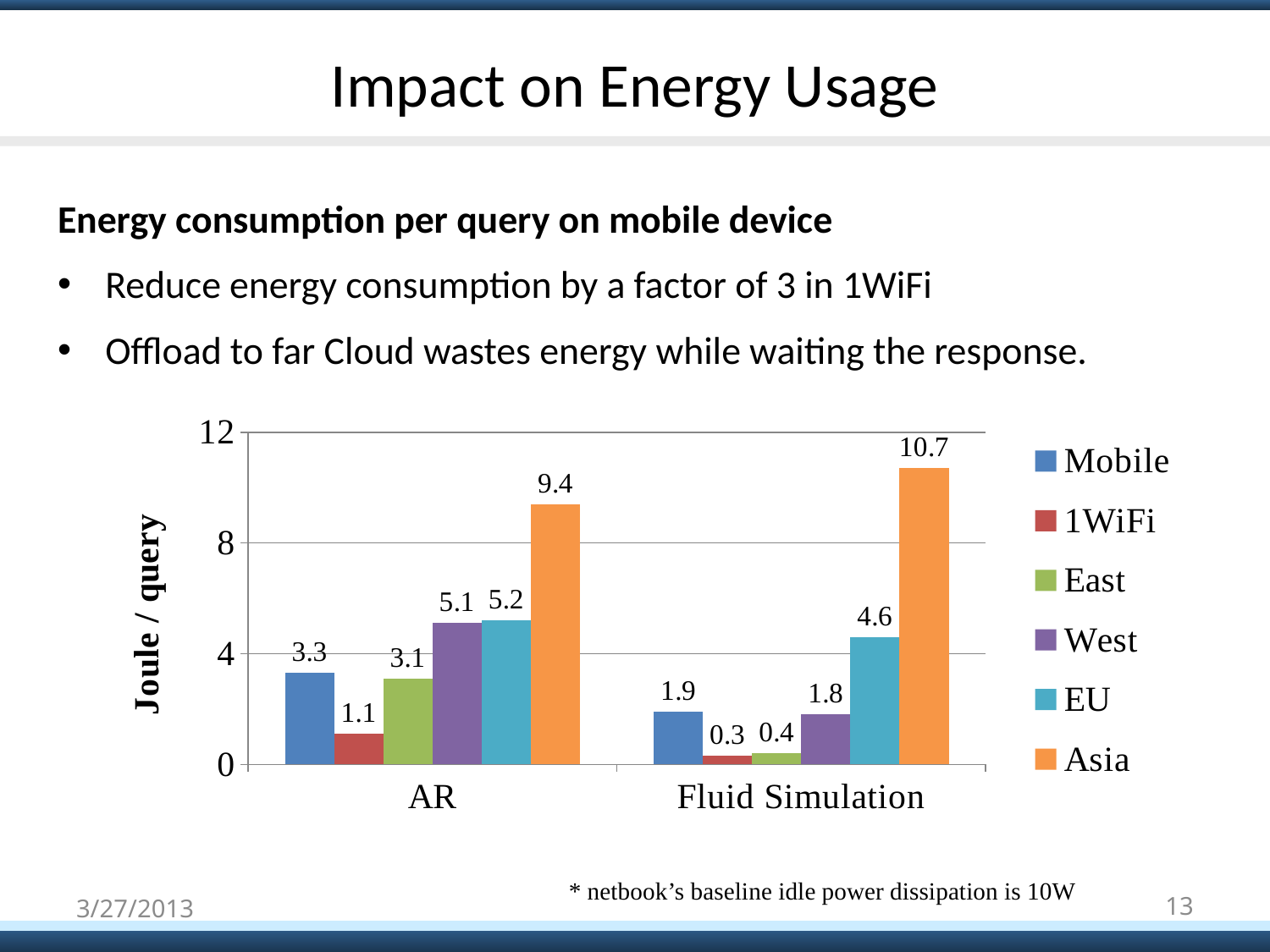
What is the value for Asia in the Fluid Simulation category? 10.7 What is the label of the y axis? Joule / query Which is larger: the Asia value for AR or the Asia value for Fluid Simulation? Fluid Simulation What is the value for EU in the AR category? 5.2 Which series has the lowest value in the AR category? 1WiFi How many categories are shown on the x axis? 2 Is the value for West in the AR category greater or less than 4? greater What is the difference between the Mobile and 1WiFi values in the AR category? 2.2 How many series does the legend list? 6 What is the value for 1WiFi in the AR category? 1.1 What kind of chart is shown on the slide? bar chart Which series has the highest value in the Fluid Simulation category? Asia